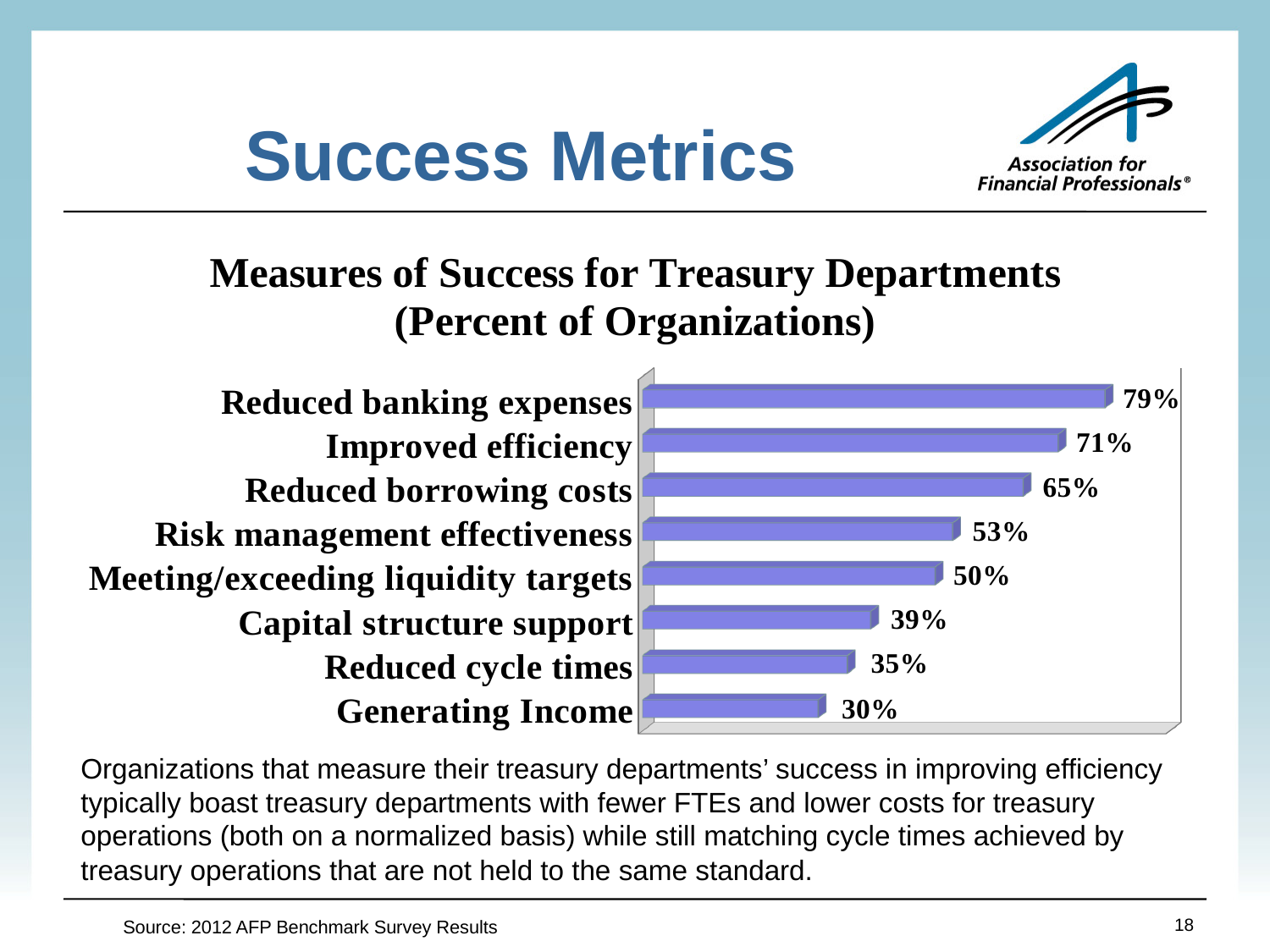
What is the value for Meeting/exceeding liquidity targets? 50% Which measure of success has the lowest percentage of organizations? Generating Income How many measures of success are shown in the chart? 8 What is the difference between the values for Reduced banking expenses and Generating Income? 49% What is the value for Risk management effectiveness? 53% What percentage of organizations use reduced banking expenses as a measure of success? 79% What kind of chart is shown on the slide? Bar chart Which measure of success has the highest percentage of organizations? Reduced banking expenses What is the title of the chart? Measures of Success for Treasury Departments (Percent of Organizations) What is the value for Generating Income? 30% Which is larger, the value for Capital structure support or the value for Reduced cycle times? Capital structure support What is the difference between the values for Improved efficiency and Reduced borrowing costs? 6%